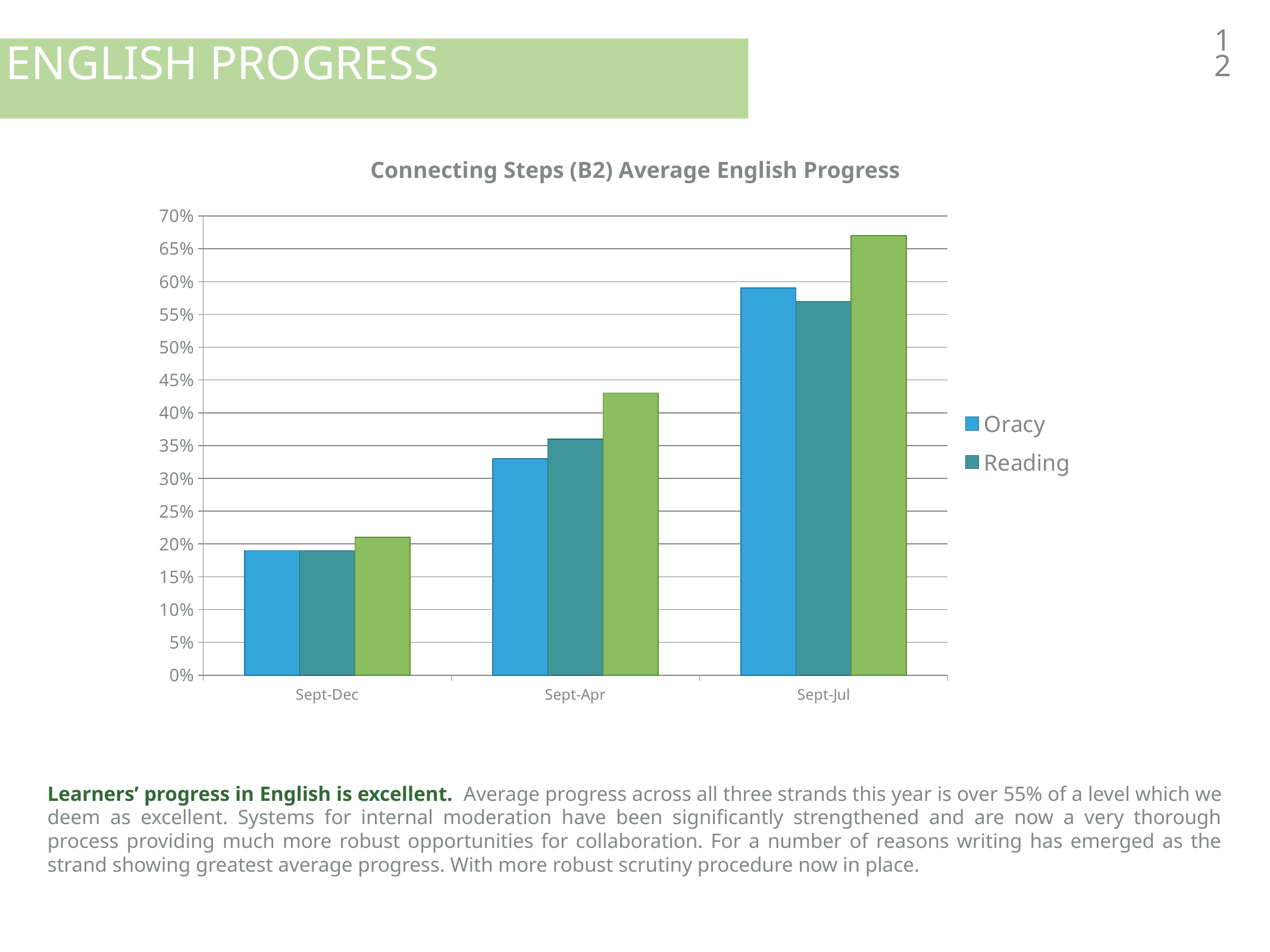
In which period is the Oracy value highest? Sept-Jul How many series does the chart legend list? 2 Is the Reading value for Sept-Apr greater or less than 40%? less Is the Oracy value for Sept-Dec greater or less than 25%? less Do the Oracy values rise or fall from Sept-Dec to Sept-Jul? rise What is the title of the chart? Connecting Steps (B2) Average English Progress What kind of chart is shown on the slide? bar chart Is the Oracy value for Sept-Apr greater or less than 30%? greater How many categories are shown on the x axis? 3 For Sept-Apr, which is larger: Oracy or Reading? Reading In which period is the Reading value lowest? Sept-Dec